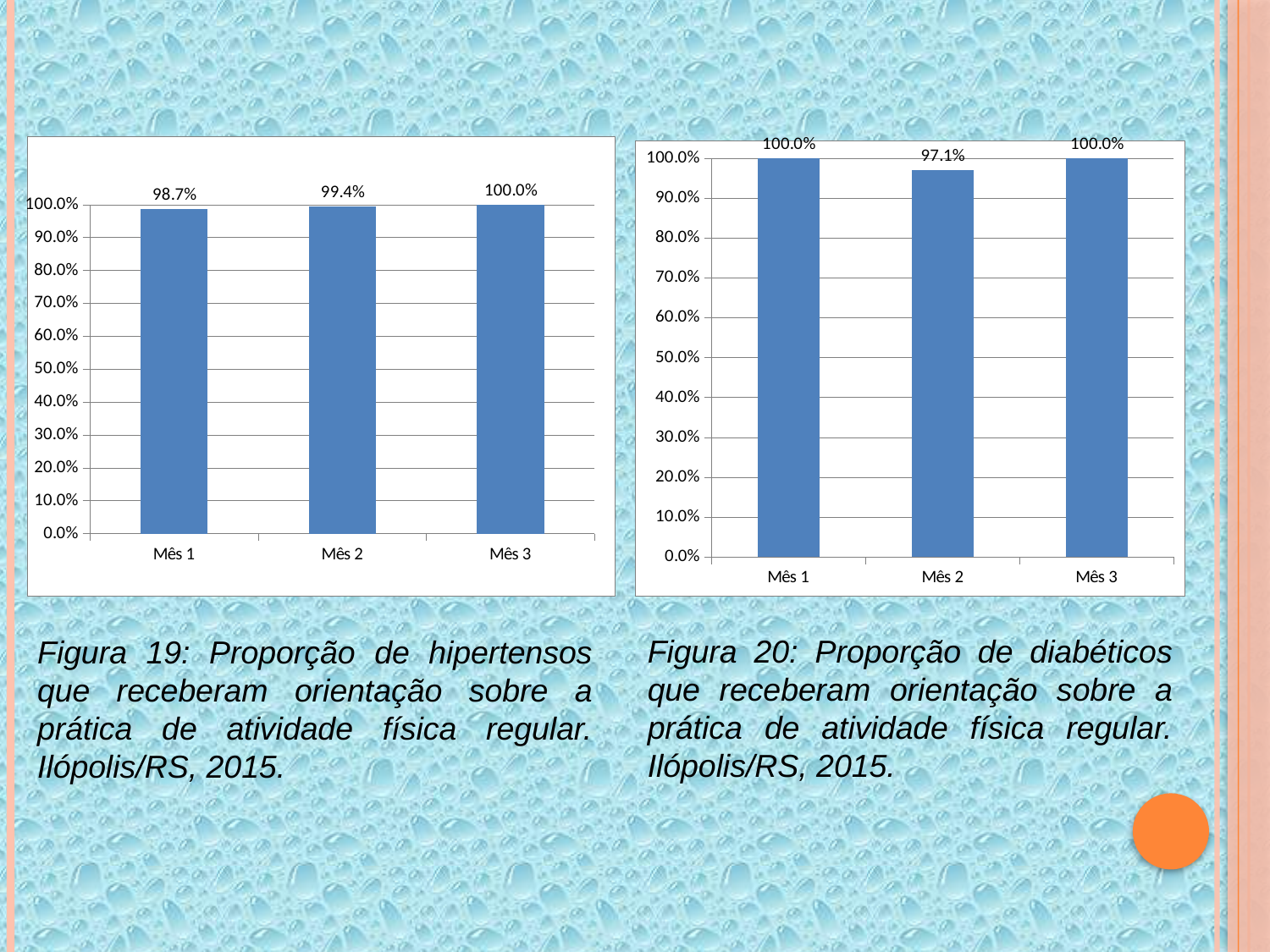
In the left chart (Figura 19), what is the value for Mês 1? 98.7% In the right chart (Figura 20), which is larger, the value for Mês 1 or Mês 2? Mês 1 In the left chart (Figura 19), what is the value for Mês 2? 99.4% What type of chart is the right chart (Figura 20)? bar chart In the right chart (Figura 20), is the value for Mês 2 greater or less than 90.0%? greater In the left chart (Figura 19), do the values rise or fall from Mês 1 to Mês 3? rise In the left chart (Figura 19), what is the difference between Mês 3 and Mês 1? 1.3% In the right chart (Figura 20), which month has the lowest value? Mês 2 How many bars are shown in the left chart (Figura 19)? 3 In the right chart (Figura 20), what is the value for Mês 2? 97.1% In the right chart (Figura 20), what is the difference between Mês 1 and Mês 2? 2.9% In the left chart (Figura 19), which month has the lowest value? Mês 1